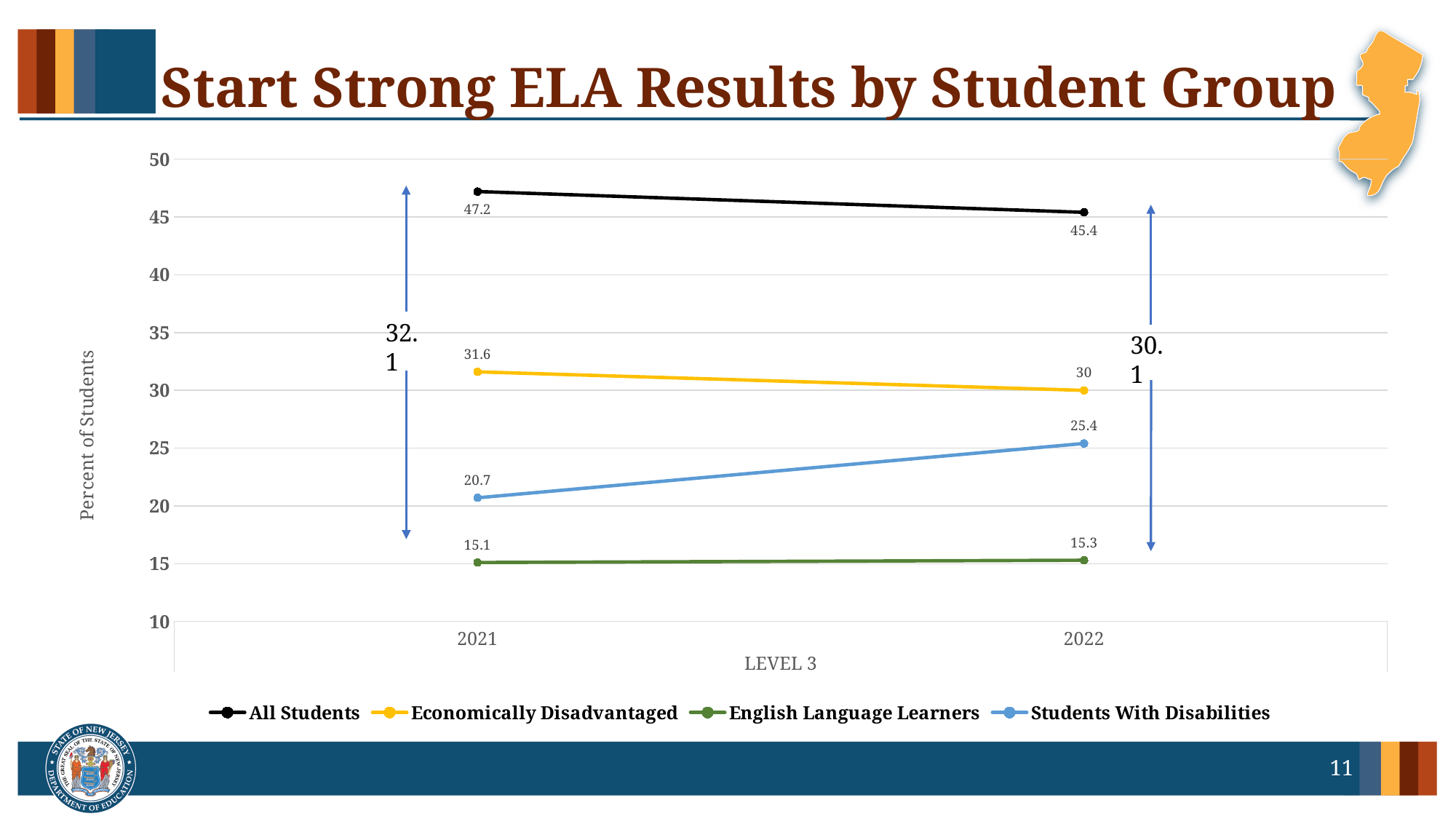
Which student group has the highest value in 2022? All Students Does the value for Students With Disabilities rise or fall from 2021 to 2022? rise What kind of chart is shown on the slide? line chart What is the value for Students With Disabilities in 2022? 25.4 What is the difference between Economically Disadvantaged and Students With Disabilities in 2021? 10.9 What is the label on the y axis? Percent of Students What is the difference between the All Students values in 2021 and 2022? 1.8 Which student group has the lowest value in 2021? English Language Learners Which is larger: Students With Disabilities in 2022 or Economically Disadvantaged in 2022? Economically Disadvantaged in 2022 What is the value for Economically Disadvantaged in 2022? 30 What is the value for All Students in 2021? 47.2 How many series does the legend list? 4